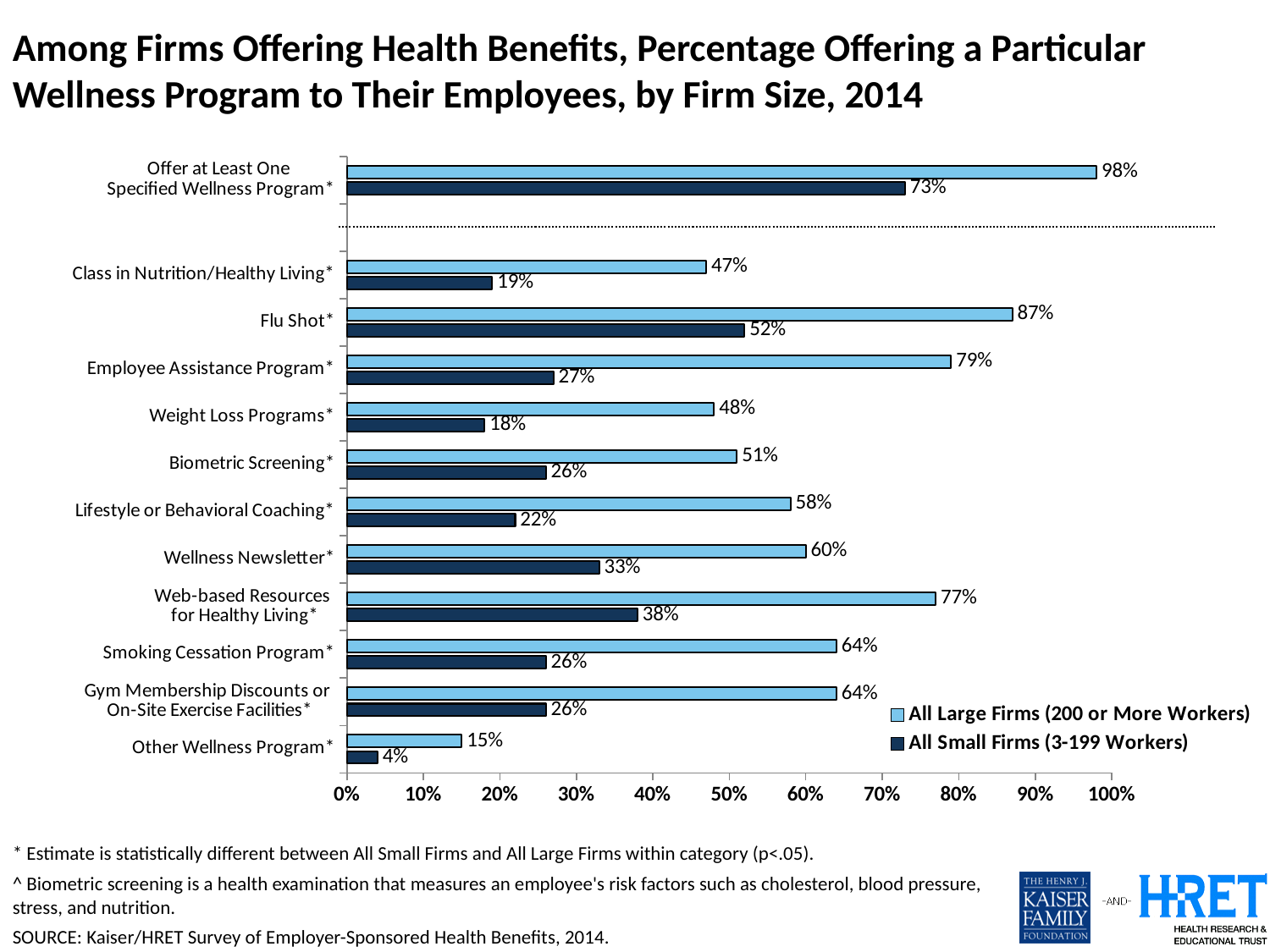
What kind of chart is shown on the slide? Bar chart What percentage of All Small Firms (3-199 Workers) offer Web-based Resources for Healthy Living? 38% Which series is shown in the darker blue colour in the legend? All Small Firms (3-199 Workers) How many series does the legend list? 2 What is the difference between All Large Firms and All Small Firms for Employee Assistance Program? 52 percentage points What percentage of All Large Firms (200 or More Workers) offer a Flu Shot? 87% Which is larger for All Small Firms (3-199 Workers): Wellness Newsletter or Biometric Screening? Wellness Newsletter Among the specific wellness programs listed below the dotted line, which has the highest value for All Large Firms (200 or More Workers)? Flu Shot What percentage of All Large Firms offer at least one specified wellness program? 98% Which category has the lowest value for All Small Firms (3-199 Workers)? Other Wellness Program How many categories are shown on the chart? 12 What percentage of All Small Firms (3-199 Workers) offer an Other Wellness Program? 4%